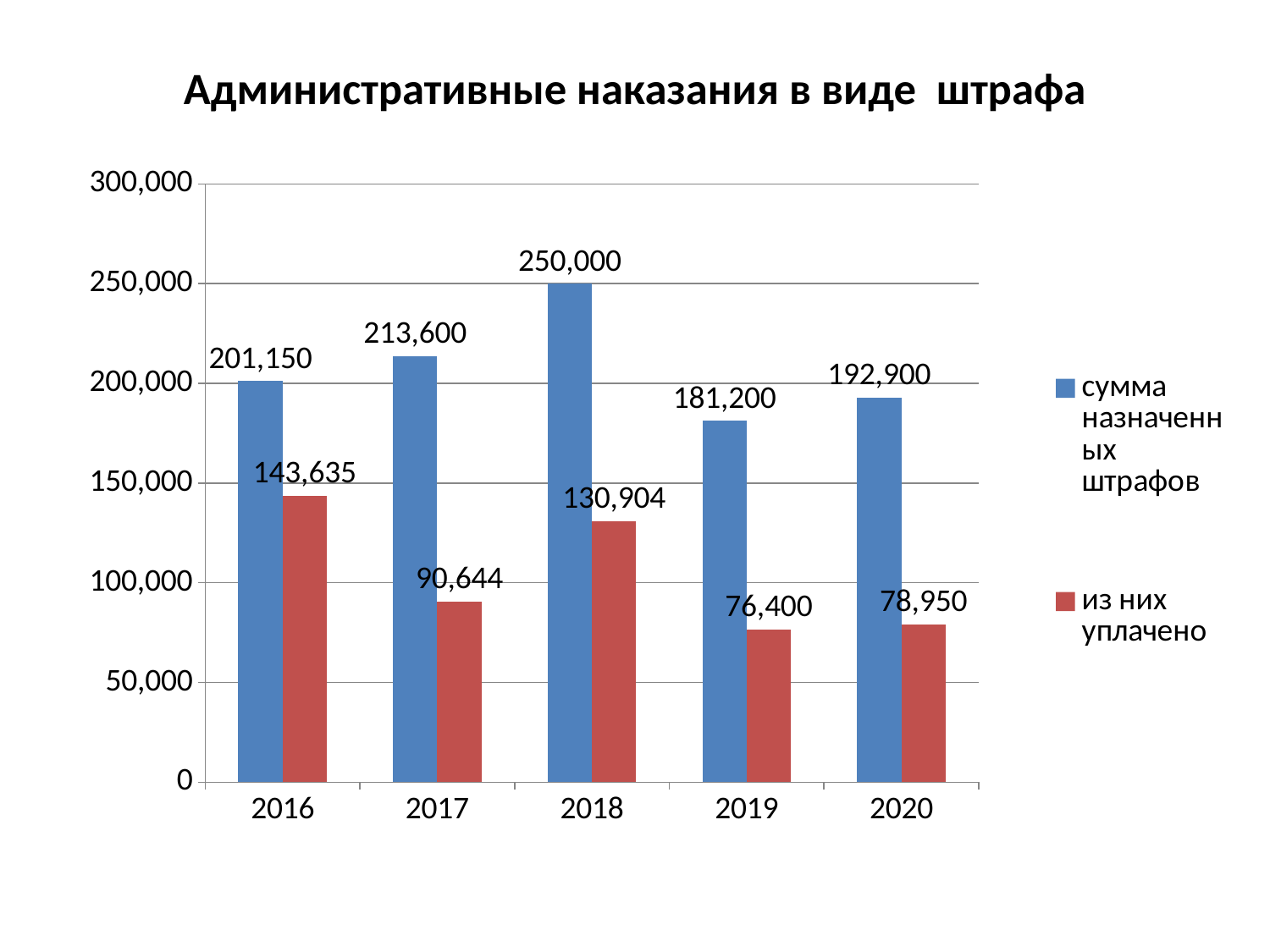
What is the value of "из них уплачено" for 2017? 90,644 In which year is "из них уплачено" the lowest? 2019 What kind of chart is shown on the slide? bar chart What is the value of "сумма назначенных штрафов" for 2018? 250,000 What is the value of "из них уплачено" for 2020? 78,950 How many series does the legend list? 2 In which year is "сумма назначенных штрафов" the highest? 2018 What is the difference between "сумма назначенных штрафов" and "из них уплачено" in 2016? 57,515 How many years are shown on the x axis? 5 Is the value of "из них уплачено" for 2018 greater or less than 100,000? greater Which is larger: "сумма назначенных штрафов" in 2017 or in 2020? 2017 What is the title of the chart? Административные наказания в виде штрафа